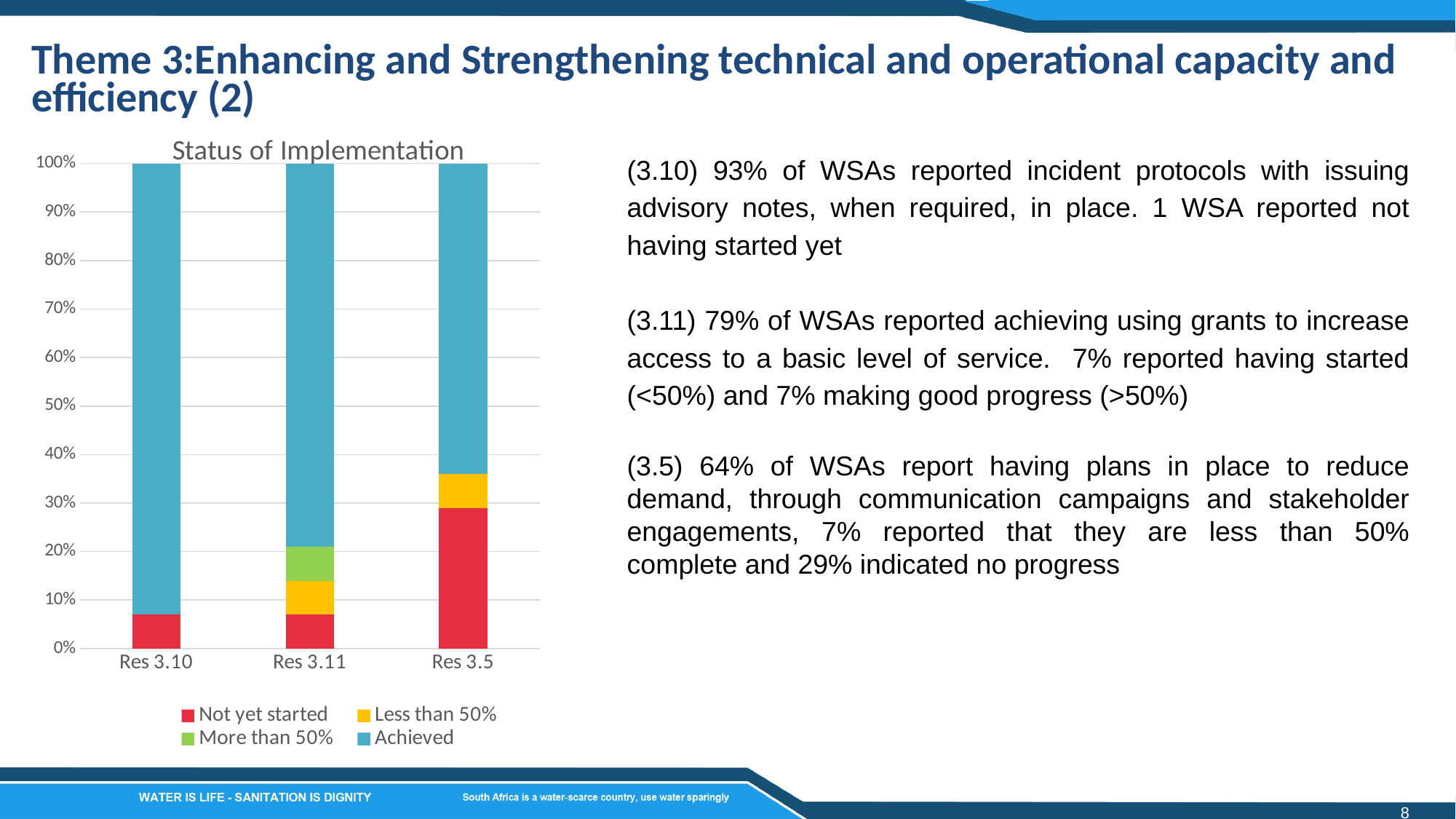
Which category has the smallest Achieved portion? Res 3.5 Is the Not yet started portion for Res 3.10 greater or less than 10%? less How many series does the chart legend list? 4 Is the Achieved portion for Res 3.5 greater or less than 70%? less What is the title of the chart? Status of Implementation How many categories are shown on the x axis of the chart? 3 Is the Achieved portion for Res 3.10 greater or less than 90%? greater Which category is the only one with a More than 50% segment? Res 3.11 Which category has the largest Achieved portion? Res 3.10 Is the Not yet started portion larger for Res 3.5 or for Res 3.10? Res 3.5 Which category has the largest Not yet started portion? Res 3.5 What kind of chart is shown on the slide? Stacked bar chart